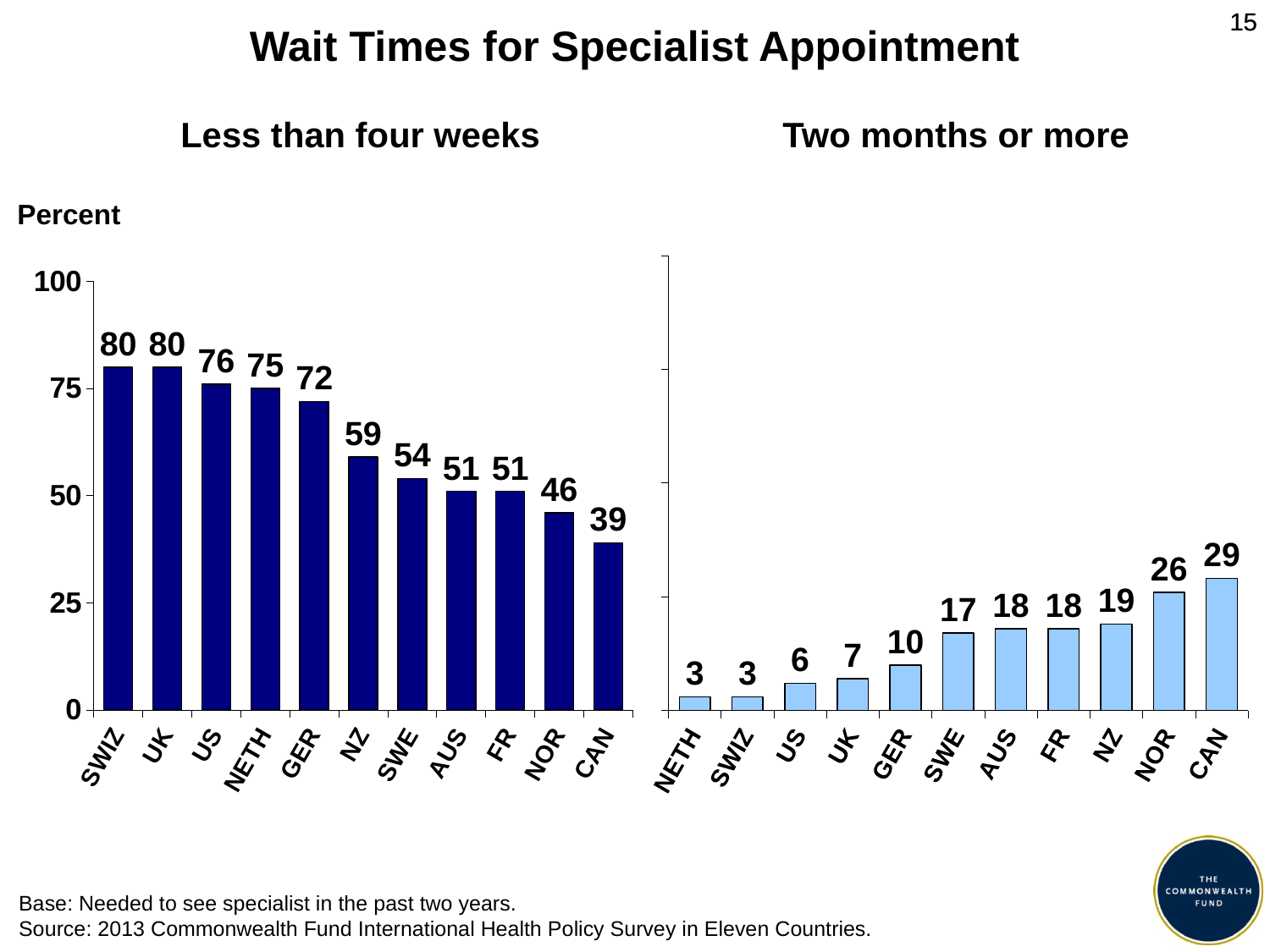
In the 'Less than four weeks' chart, what is the difference between the values for SWIZ and CAN? 41 How many countries are shown in the 'Less than four weeks' chart? 11 In the 'Less than four weeks' chart, which country has the lowest value? CAN What is the title of the slide? Wait Times for Specialist Appointment In the 'Less than four weeks' chart, what is the value for GER? 72 What kind of chart is the 'Two months or more' chart? bar chart In the 'Two months or more' chart, is the value for NZ greater or less than 25? less In the 'Two months or more' chart, what is the difference between the values for CAN and NETH? 26 In the 'Two months or more' chart, do the values rise or fall from left to right? rise In the 'Less than four weeks' chart, which is larger, the value for NZ or the value for SWE? NZ In the 'Two months or more' chart, which country has the highest value? CAN In the 'Two months or more' chart, what is the value for NOR? 26